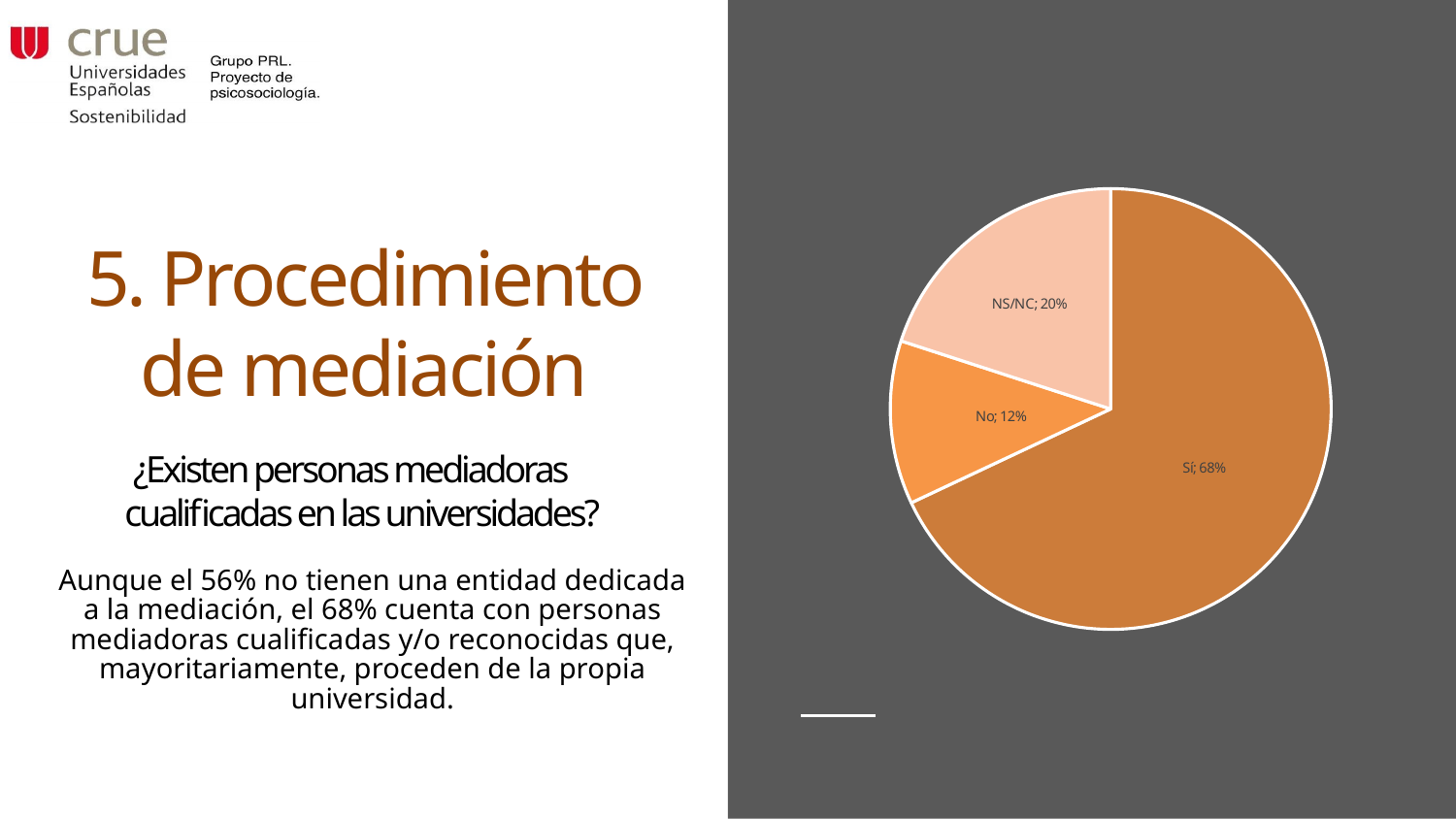
What share of the pie does the "Sí" slice represent? 68% What percentage of the pie chart corresponds to "No"? 12% What percentage of the pie chart corresponds to "NS/NC"? 20% What percentage of the pie chart corresponds to "Sí"? 68% What is the difference in percentage points between the "Sí" slice and the "NS/NC" slice? 48 What kind of chart is shown on the slide? pie chart Which slice is larger, "No" or "NS/NC"? NS/NC Which slice of the pie chart is the largest? Sí How many slices does the pie chart have? 3 What is the difference in percentage points between the "NS/NC" slice and the "No" slice? 8 Which slice of the pie chart is the smallest? No Which slice of the pie chart is shown in the lightest colour? NS/NC